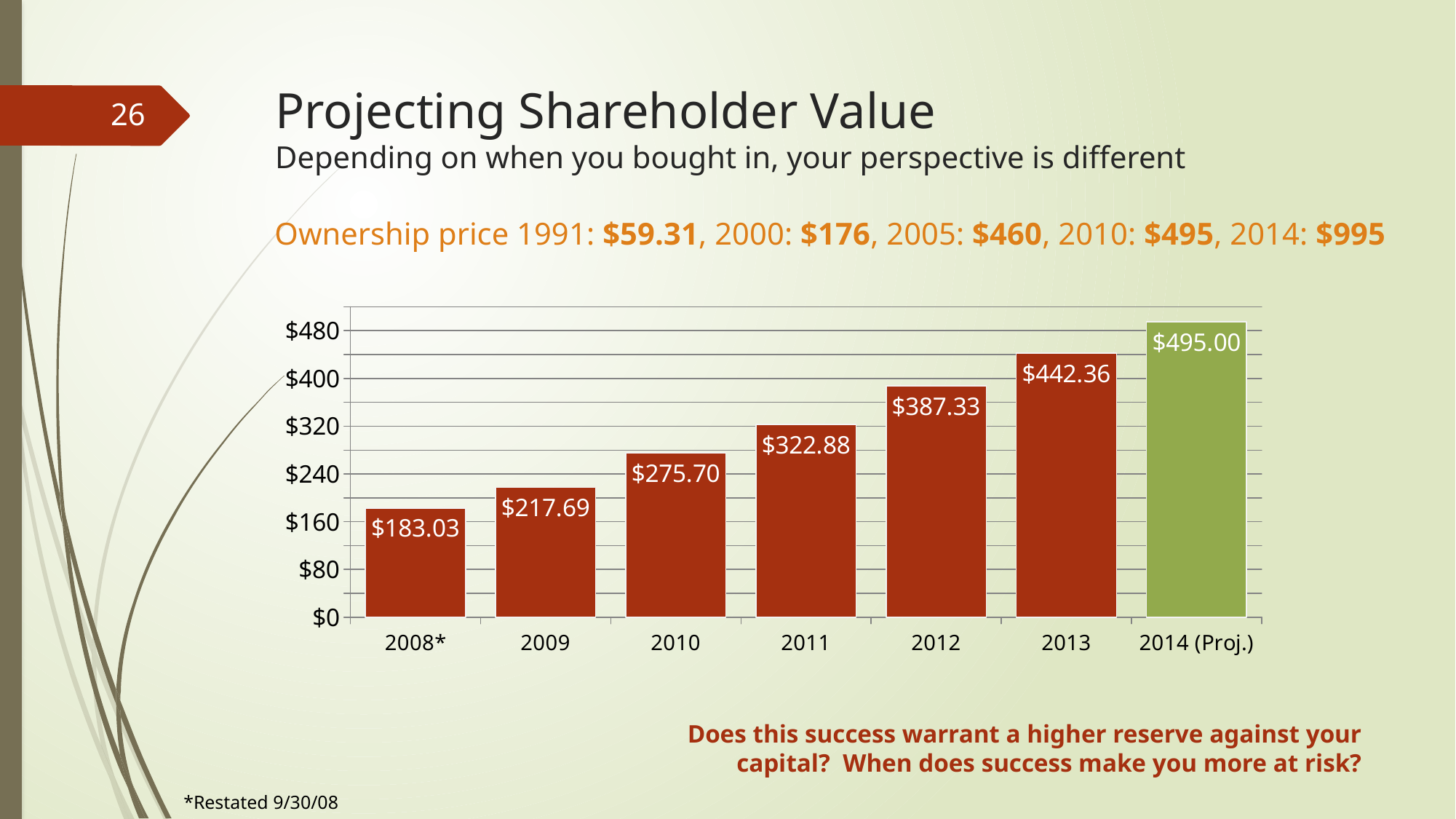
Which is larger, the value for 2010 or the value for 2009? 2010 What is the difference between the values for 2013 and 2012? $55.03 What is the value shown for 2008*? $183.03 Which year has the lowest value in the chart? 2008* What is the value shown for 2011? $322.88 Which bar in the chart is coloured green instead of red? 2014 (Proj.) Do the values rise or fall from 2008* to 2014 (Proj.)? rise Which year has the highest value in the chart? 2014 (Proj.) What is the projected value for 2014 (Proj.)? $495.00 What kind of chart is shown on the slide? bar chart Is the value for 2012 greater or less than $400? less How many years are shown on the x axis of the chart? 7